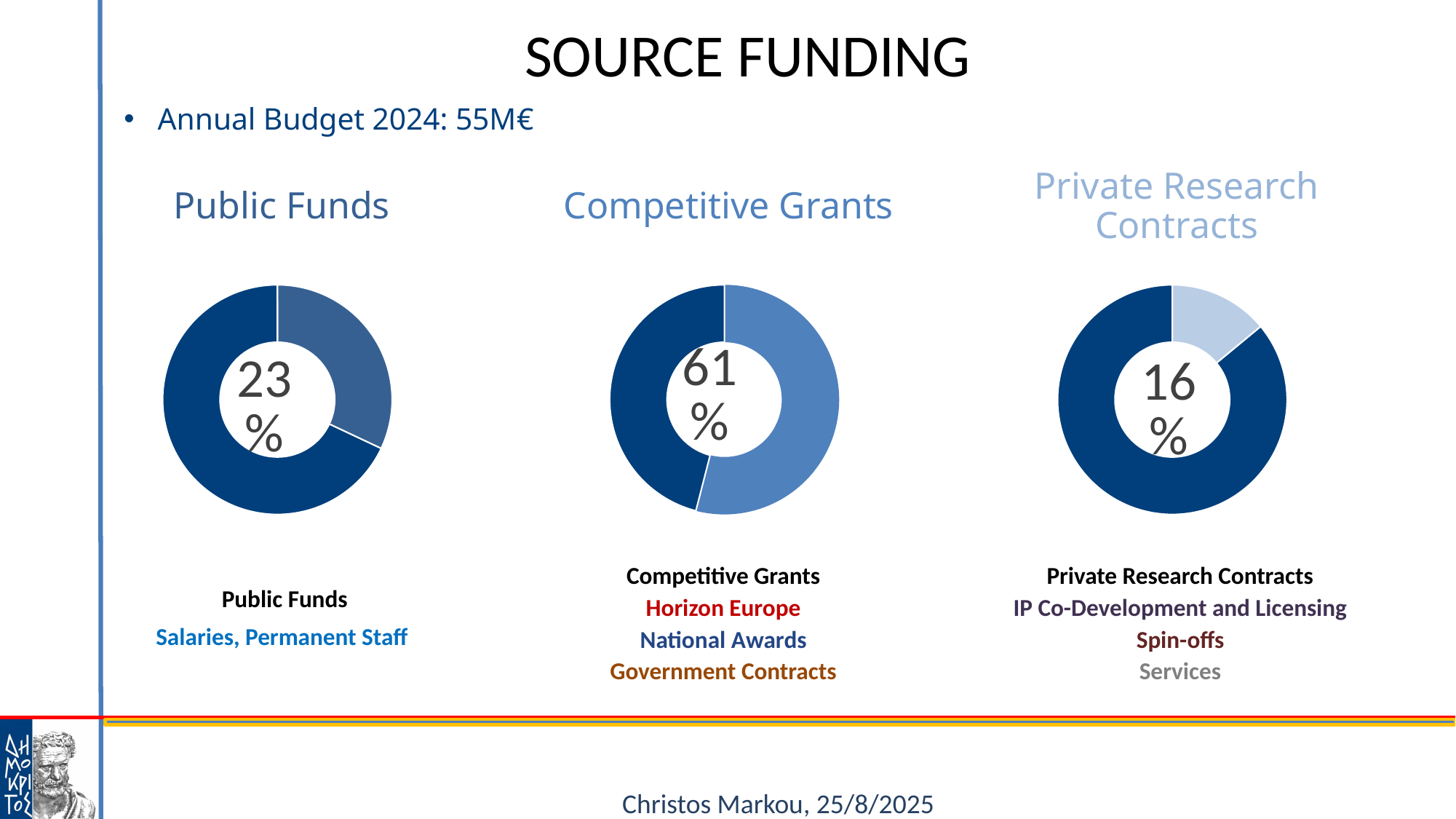
How many donut charts are shown on the slide? 3 What annual budget for 2024 is stated above the charts? 55M€ What percentage is shown in the centre of the Competitive Grants donut chart? 61% What is the difference in percentage points between the Competitive Grants share and the Public Funds share? 38 What percentage is shown in the centre of the Private Research Contracts donut chart? 16% What is the total of the three percentages shown in the donut charts? 100% Which is larger, the Public Funds share or the Private Research Contracts share? Public Funds What kind of chart is used to show each funding source's share? Donut (pie) chart What percentage is shown in the centre of the Public Funds donut chart? 23% What is the difference in percentage points between the Public Funds share and the Private Research Contracts share? 7 Which of the three funding sources has the smallest share? Private Research Contracts Which of the three funding sources has the largest share? Competitive Grants